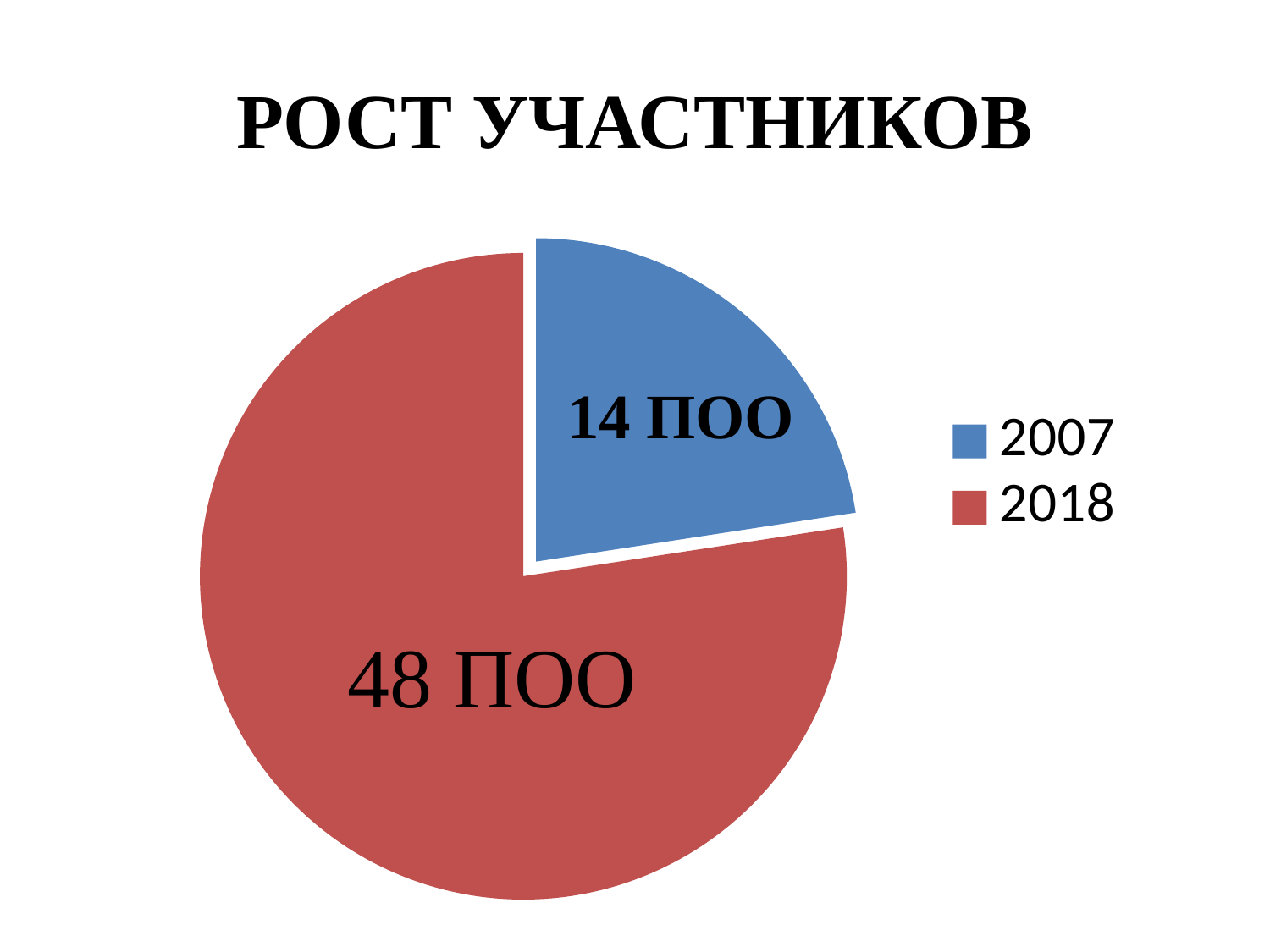
Which year has the smallest slice in the pie chart? 2007 What is the combined total of the two slices in the pie chart? 62 ПОО What is the value shown for the 2018 slice of the pie chart? 48 ПОО How many slices does the pie chart have? 2 What is the title of the chart on the slide? РОСТ УЧАСТНИКОВ By how many ПОО does the 2018 value exceed the 2007 value? 34 ПОО Which year has the largest slice in the pie chart? 2018 Which is larger, the value for 2007 or the value for 2018? 2018 What kind of chart is shown on the slide? Pie chart What colour is the slice for 2007 in the pie chart? Blue How many entries does the legend list? 2 What is the value shown for the 2007 slice of the pie chart? 14 ПОО